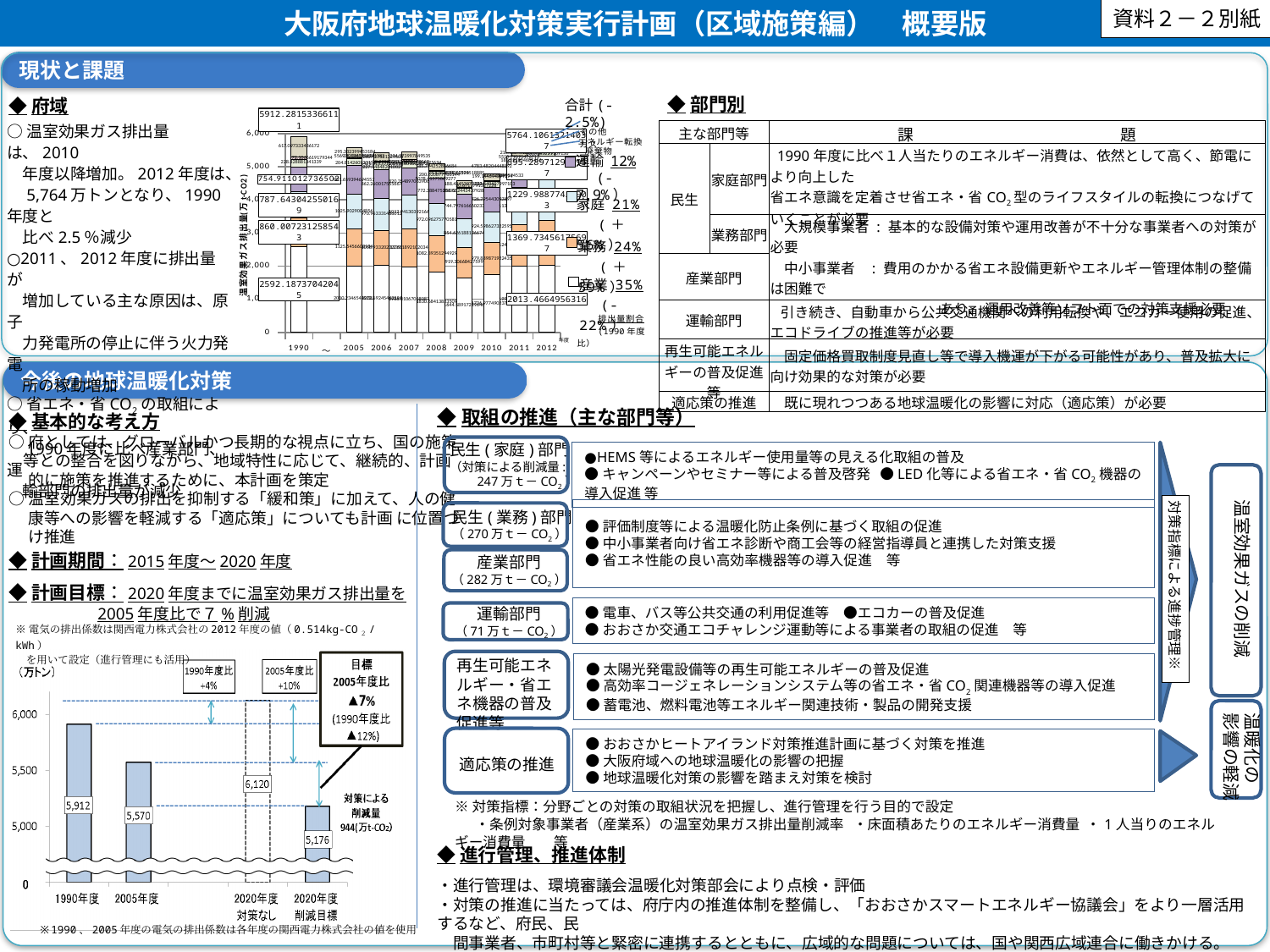
In the bottom-left bar chart, what is the value for 2005年度? 5,570 In the bottom-left bar chart, what is the difference between 1990年度 and 2005年度? 342 What kind of chart is the bottom-left chart? bar chart In the bottom-left bar chart, which is larger, 1990年度 or 2005年度? 1990年度 In the bottom-left bar chart, what is the value for 1990年度? 5,912 In the bottom-left bar chart, what is the value for 2020年度 対策なし? 6,120 In the bottom-left bar chart, which category has the highest value? 2020年度 対策なし What kind of chart is the 温室効果ガス排出量 chart at the top of the slide? stacked bar chart In the bottom-left bar chart, what is the difference between 2020年度 対策なし and 2020年度 削減目標? 944 In the bottom-left bar chart, which category has the lowest value? 2020年度 削減目標 In the bottom-left bar chart, what is the value for 2020年度 削減目標? 5,176 How many bars are shown in the bottom-left bar chart? 4